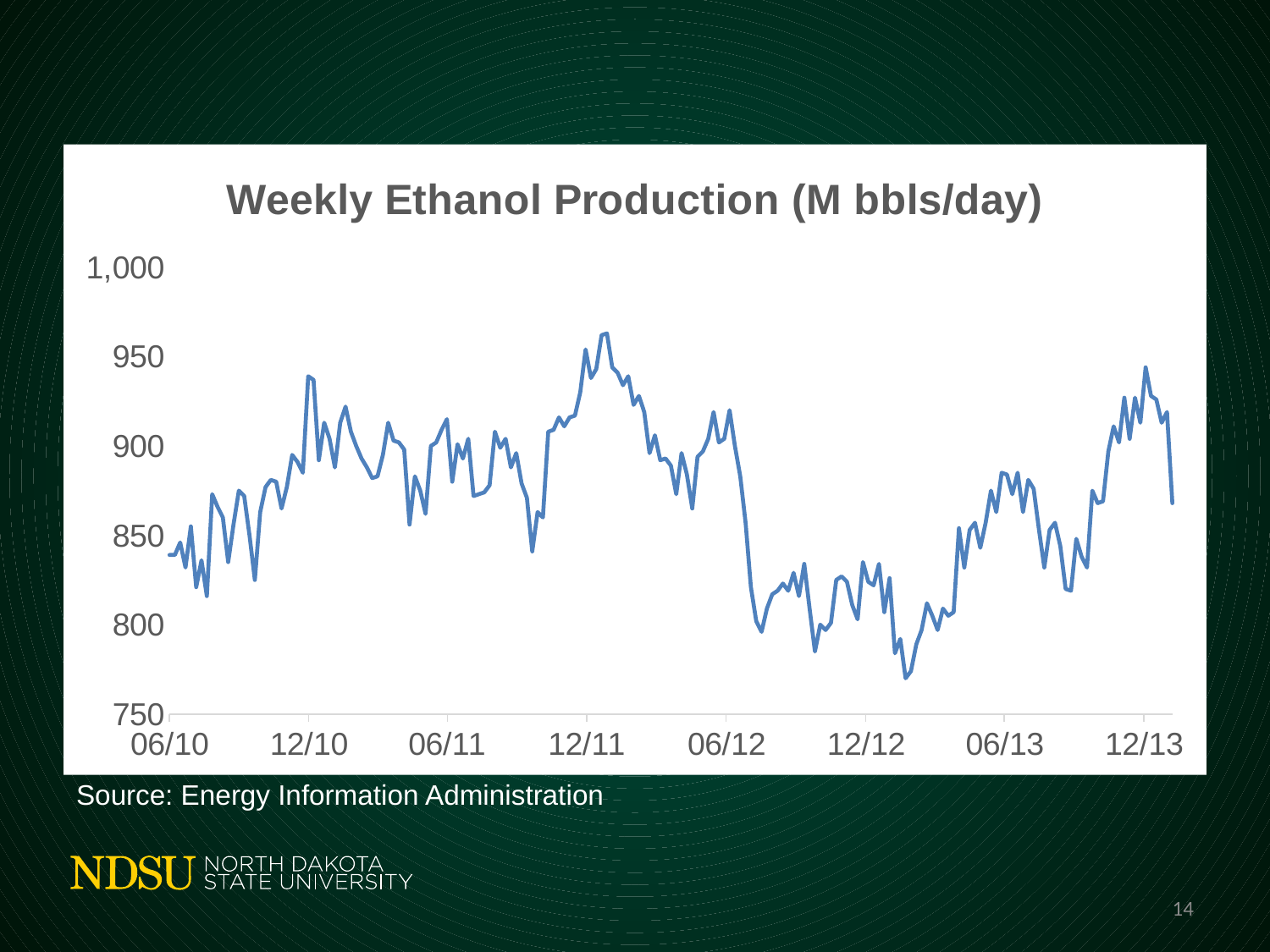
How many lines are plotted on the chart? 1 Is the value at 06/10 greater or less than 850? less What source is cited below the chart? Energy Information Administration Is the highest point on the line greater or less than 950? greater Is the lowest point on the line greater or less than 800? less What kind of chart is shown on the slide? line chart Which is larger, the value at 12/11 or the value at 12/12? 12/11 Does the line rise or fall between 06/12 and 12/12? fall What is the title of the chart? Weekly Ethanol Production (M bbls/day) How many date labels are shown on the x axis? 8